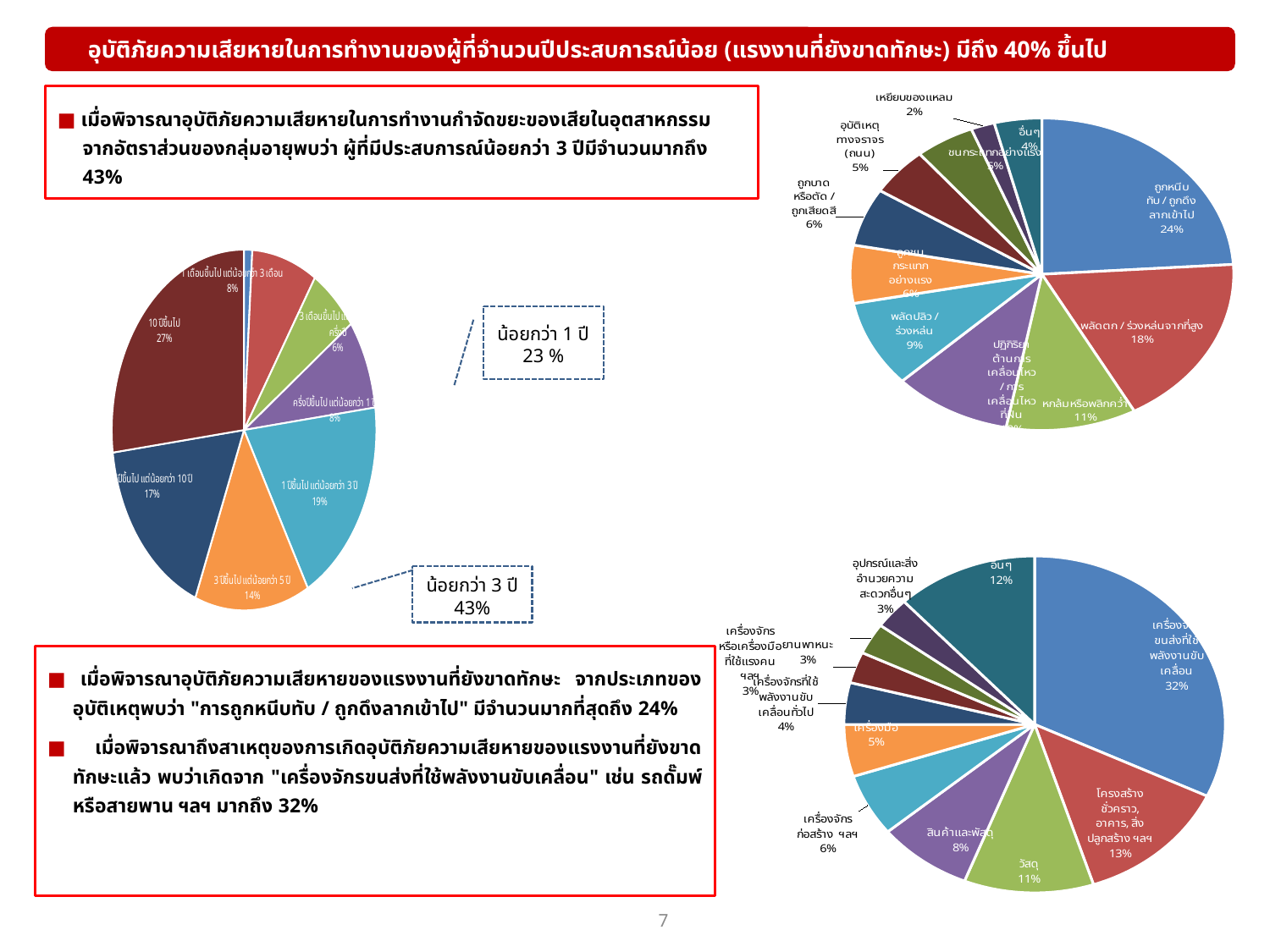
In the left pie chart (years of experience), what share is '10 ปีขึ้นไป'? 27% In the bottom-right pie chart (causes), what share is 'โครงสร้างชั่วคราว, อาคาร, สิ่งปลูกสร้าง ฯลฯ'? 13% In the top-right pie chart (accident types), which category has the largest share? ถูกหนีบทับ / ถูกดึงลากเข้าไป In the left pie chart (years of experience), what share is shown in the callout for 'น้อยกว่า 3 ปี'? 43% In the left pie chart (years of experience), what share is '1 ปีขึ้นไป แต่น้อยกว่า 3 ปี'? 19% In the bottom-right pie chart (causes), which is larger: 'วัสดุ' or 'สินค้าและพัสดุ'? วัสดุ In the bottom-right pie chart (causes), what share is 'อื่นๆ'? 12% In the top-right pie chart (accident types), what share is 'ถูกหนีบทับ / ถูกดึงลากเข้าไป'? 24% In the top-right pie chart (accident types), which category has the smallest share? เหยียบของแหลม In the top-right pie chart (accident types), what is the difference between 'ถูกหนีบทับ / ถูกดึงลากเข้าไป' and 'พลัดตก / ร่วงหล่นจากที่สูง'? 6% What type of chart is used for the three charts on this slide? Pie chart In the bottom-right pie chart (causes), what share is 'เครื่องจักรขนส่งที่ใช้พลังงานขับเคลื่อน'? 32%